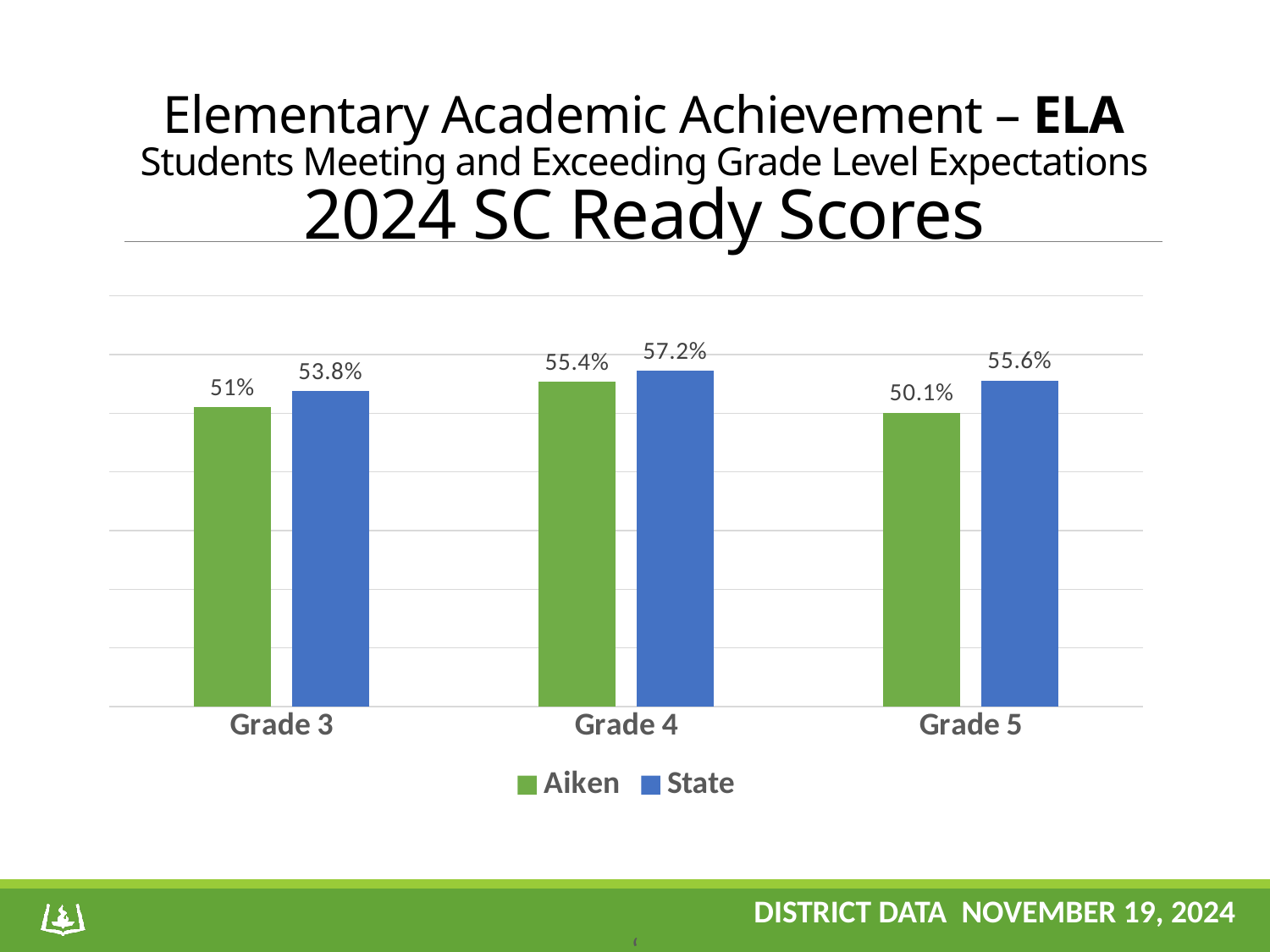
What is the difference between the State and Aiken values for Grade 4? 1.8% What is the difference between the State and Aiken values for Grade 5? 5.5% Which is larger for Grade 3, the Aiken value or the State value? State What is the Aiken value for Grade 3? 51% How many grade categories are shown on the x axis? 3 How many series does the legend list? 2 What is the State value for Grade 3? 53.8% What is the Aiken value for Grade 5? 50.1% Which grade has the highest Aiken value? Grade 4 What kind of chart is shown on the slide? Bar chart What is the State value for Grade 4? 57.2% Which grade has the lowest State value? Grade 3